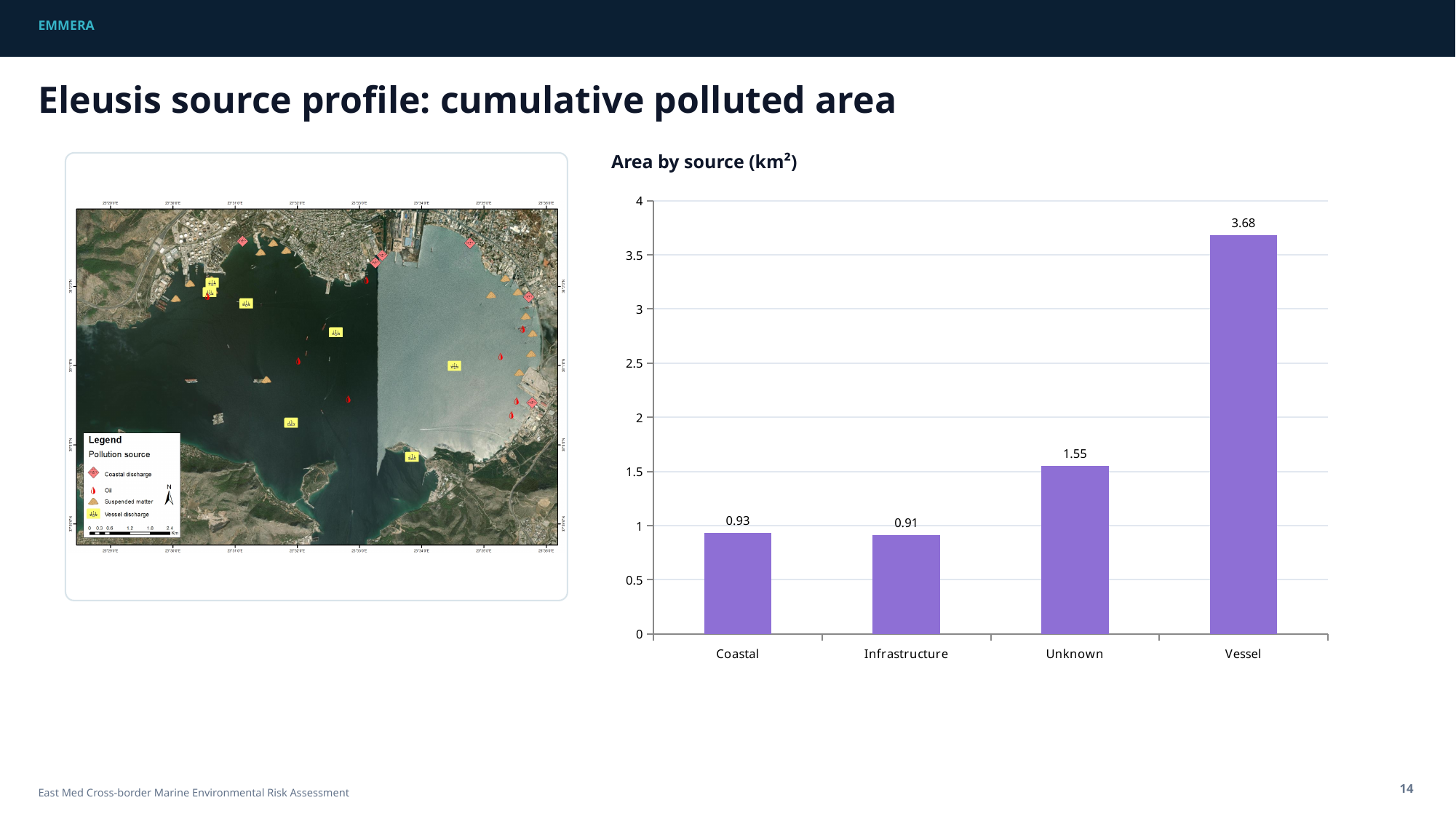
What is the difference between the Vessel and Unknown values in the Area by source (km²) chart? 2.13 Which source has the smallest area in the Area by source (km²) chart? Infrastructure In the Area by source (km²) chart, which is larger: Unknown or Coastal? Unknown What is the value for Unknown in the Area by source (km²) chart? 1.55 What kind of chart is the Area by source (km²) chart? Bar chart What is the value for Coastal in the Area by source (km²) chart? 0.93 What is the value for Infrastructure in the Area by source (km²) chart? 0.91 How many source categories are shown in the Area by source (km²) chart? 4 What is the difference between the Coastal and Infrastructure values in the Area by source (km²) chart? 0.02 Is the value for Vessel in the Area by source (km²) chart greater or less than 3.5? greater What is the value for Vessel in the Area by source (km²) chart? 3.68 Which source has the largest area in the Area by source (km²) chart? Vessel